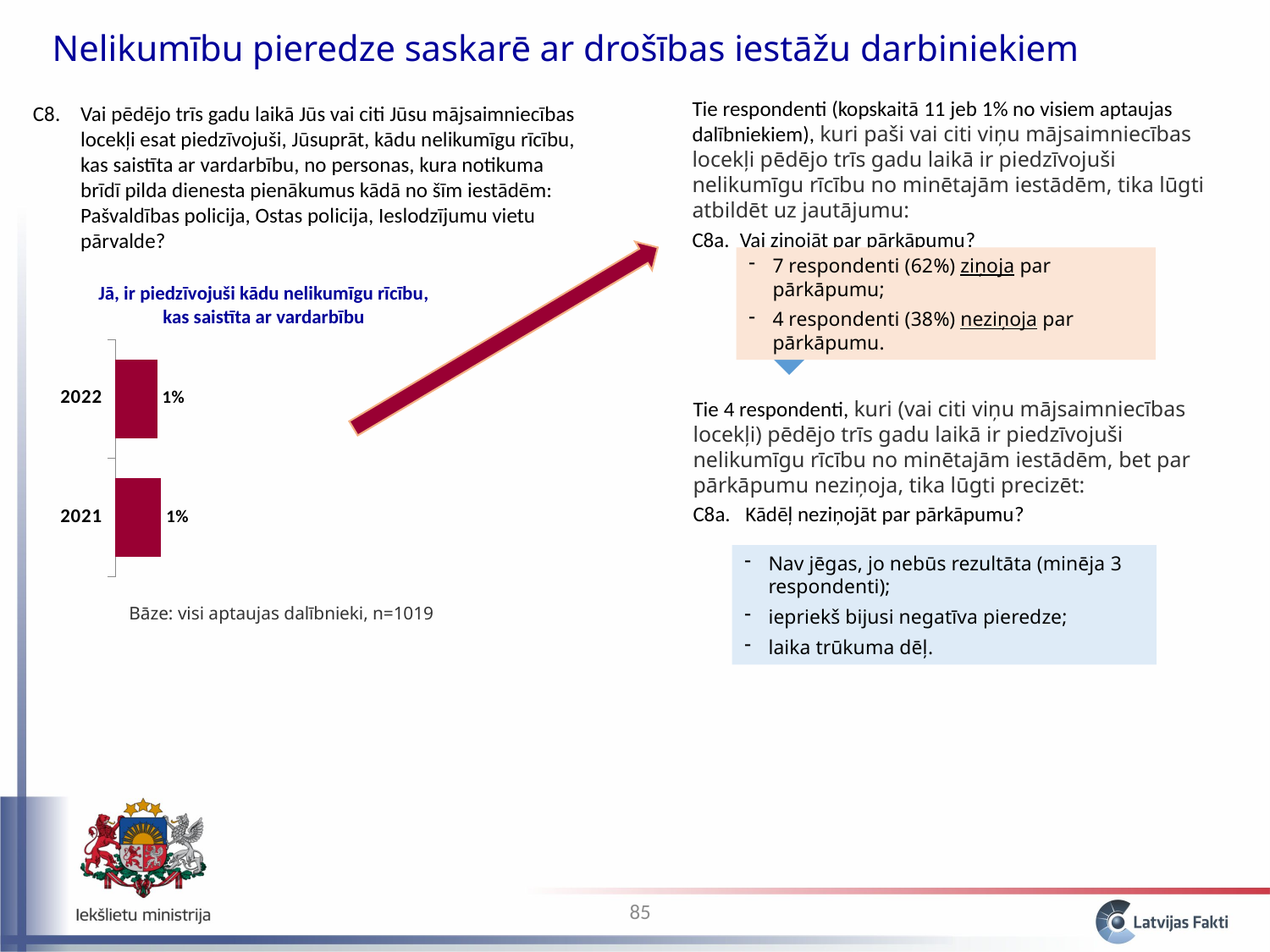
What kind of chart is shown on the slide? Bar chart Did the value change between 2021 and 2022? No, it stayed at 1% What is the title of the chart? Jā, ir piedzīvojuši kādu nelikumīgu rīcību, kas saistīta ar vardarbību What is the difference between the values for 2022 and 2021? 0% How many categories (years) are shown in the chart? 2 What is the value for 2022 in the chart? 1% What is the base (n) stated below the chart? n=1019 What is the value for 2021 in the chart? 1%